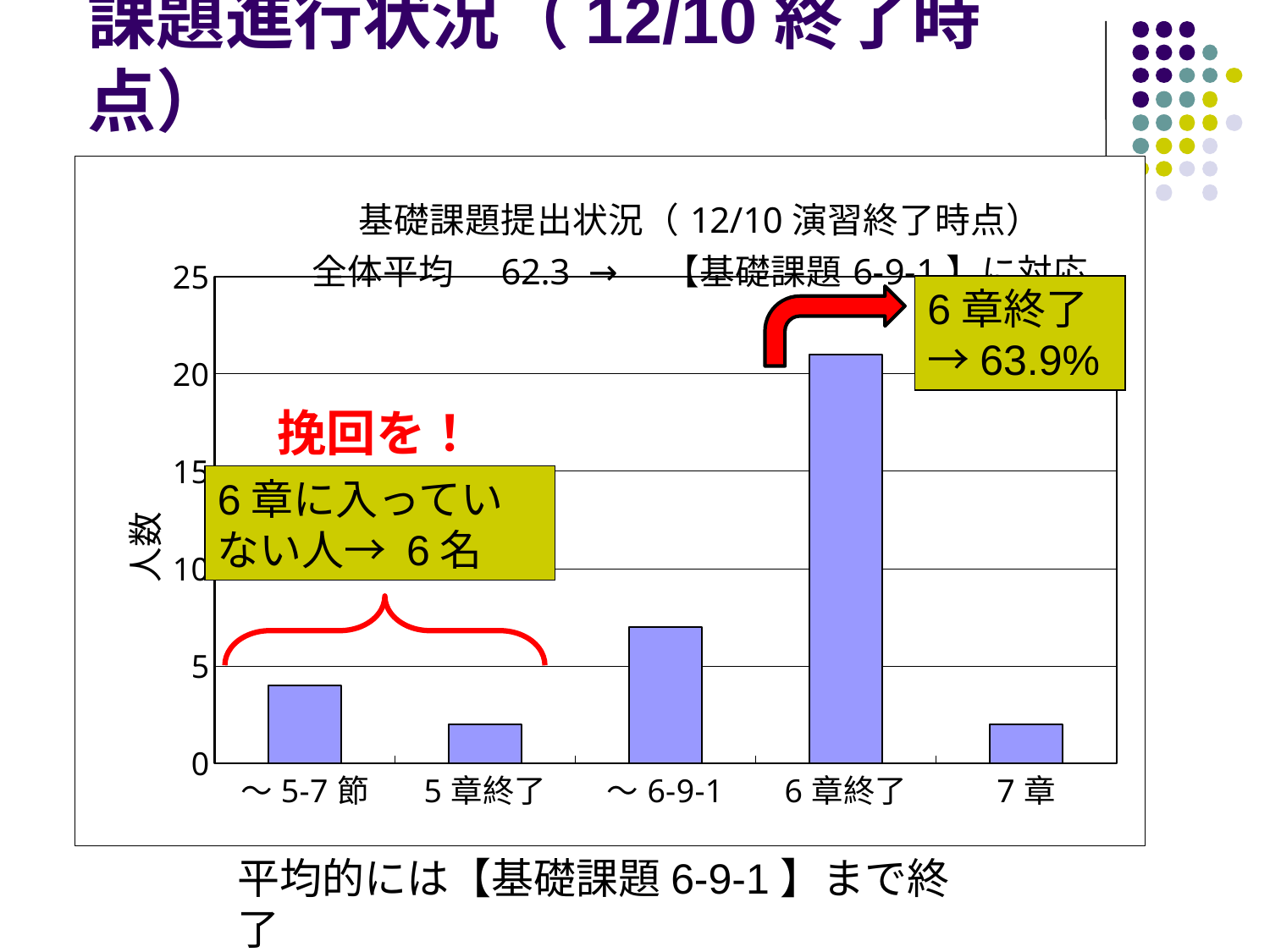
What is the label of the vertical axis of the chart? 人数 Is the value for 6章終了 greater or less than 20? greater What is the title of the chart? 基礎課題提出状況（12/10 演習終了時点） Which category has the highest bar in the chart? 6章終了 What kind of chart is shown on the slide? bar chart Is the value for ～5-7節 greater or less than 5? less Which is larger, the value for ～6-9-1 or the value for 6章終了? 6章終了 Is the value for ～6-9-1 greater or less than 5? greater Which is larger, the value for ～5-7節 or the value for 5章終了? ～5-7節 How many categories are shown on the x axis of the chart? 5